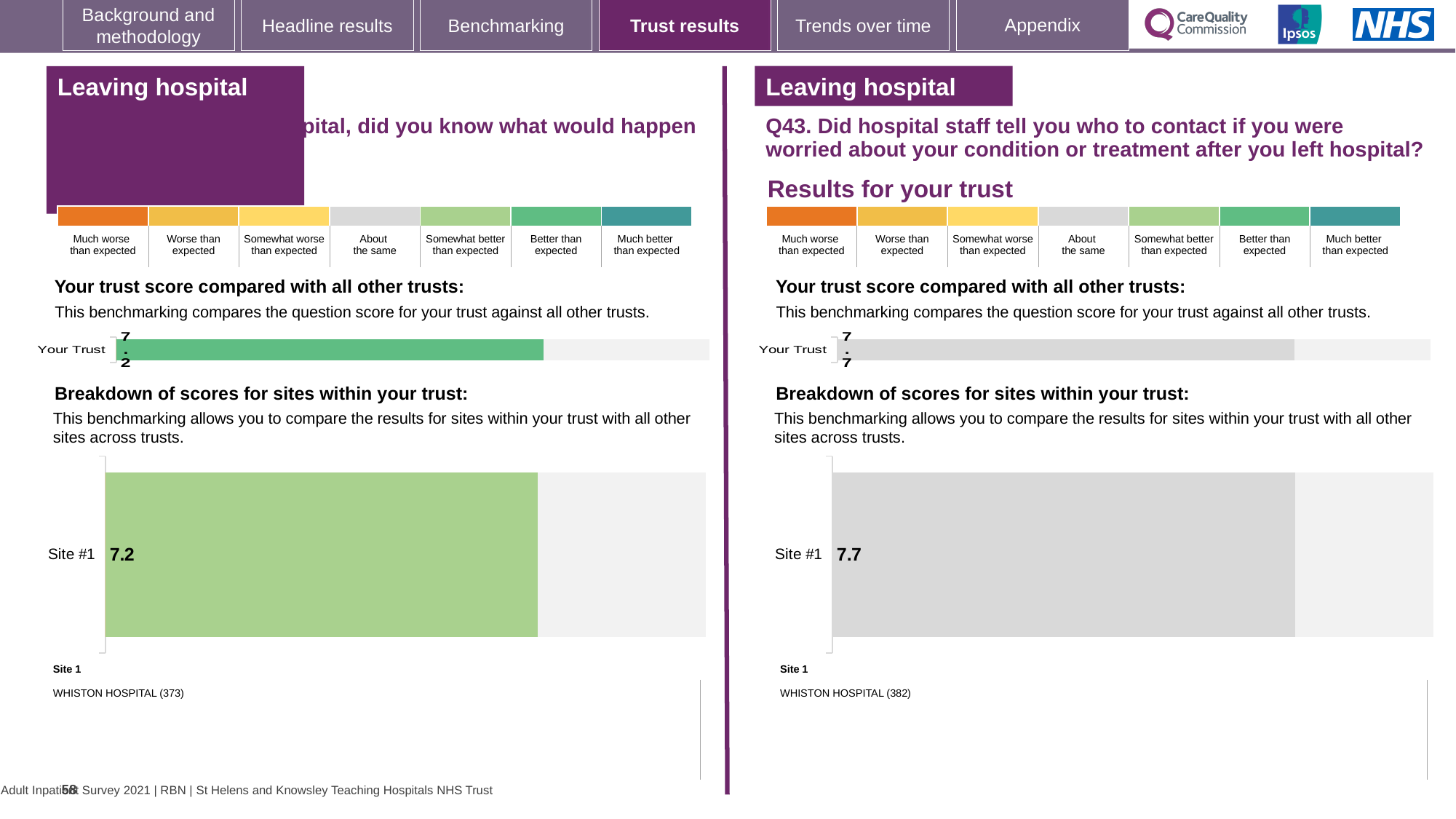
Which panel shows the higher Site #1 score, the left-hand panel or the right-hand panel (Q43)? the right-hand panel (Q43) On the left-hand panel, which site name is listed as Site 1? WHISTON HOSPITAL (373) On the left-hand panel, is the Site #1 score greater or less than 8? less How many sites are shown in the site breakdown chart on the right-hand panel (Q43)? 1 What kind of chart is used to show the Site #1 score on each panel? bar chart On the right-hand panel (Q43), what is the score shown for Site #1? 7.7 On the right-hand panel (Q43), what is the score shown for Your Trust? 7.7 On the right-hand panel (Q43), is the Your Trust score greater or less than 7? greater On the left-hand panel, what is the score shown for Site #1? 7.2 What is the difference between the Site #1 score on the right-hand panel (Q43) and the Site #1 score on the left-hand panel? 0.5 On the right-hand panel (Q43), which site name is listed as Site 1? WHISTON HOSPITAL (382) On the left-hand panel, what is the score shown for Your Trust? 7.2